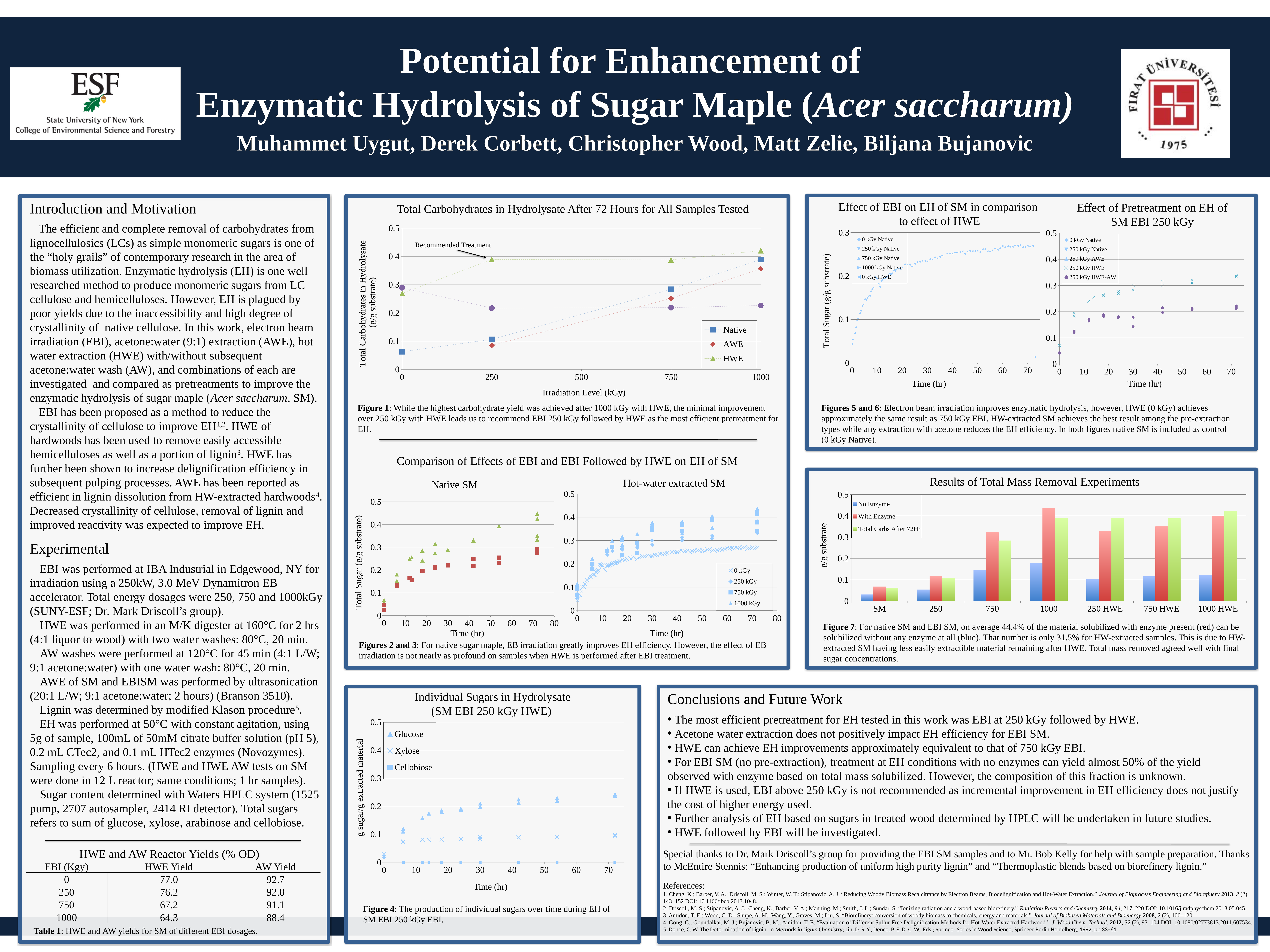
In the chart titled "Results of Total Mass Removal Experiments", which category has the highest With Enzyme bar? 1000 In the chart titled "Total Carbohydrates in Hydrolysate After 72 Hours for All Samples Tested", which series has the highest value at 250 kGy? HWE In the chart titled "Results of Total Mass Removal Experiments", is the With Enzyme value for 1000 greater or less than 0.4? greater In the chart titled "Total Carbohydrates in Hydrolysate After 72 Hours for All Samples Tested", what is the x-axis label? Irradiation Level (kGy) In the chart titled "Total Carbohydrates in Hydrolysate After 72 Hours for All Samples Tested", is the HWE value at 250 kGy greater or less than 0.3? greater In the chart titled "Total Carbohydrates in Hydrolysate After 72 Hours for All Samples Tested", how many series does the legend list? 3 In the chart titled "Results of Total Mass Removal Experiments", how many categories are shown on the x axis? 7 What kind of chart is "Results of Total Mass Removal Experiments"? bar chart In the chart titled "Results of Total Mass Removal Experiments", which is larger: the With Enzyme value for 750 or for 1000? 1000 In the chart titled "Total Carbohydrates in Hydrolysate After 72 Hours for All Samples Tested", is the Native value at 0 kGy greater or less than 0.1? less In the chart titled "Individual Sugars in Hydrolysate (SM EBI 250 kGy HWE)", do the Glucose values rise or fall over time? rise In the chart titled "Individual Sugars in Hydrolysate (SM EBI 250 kGy HWE)", how many series does the legend list? 3